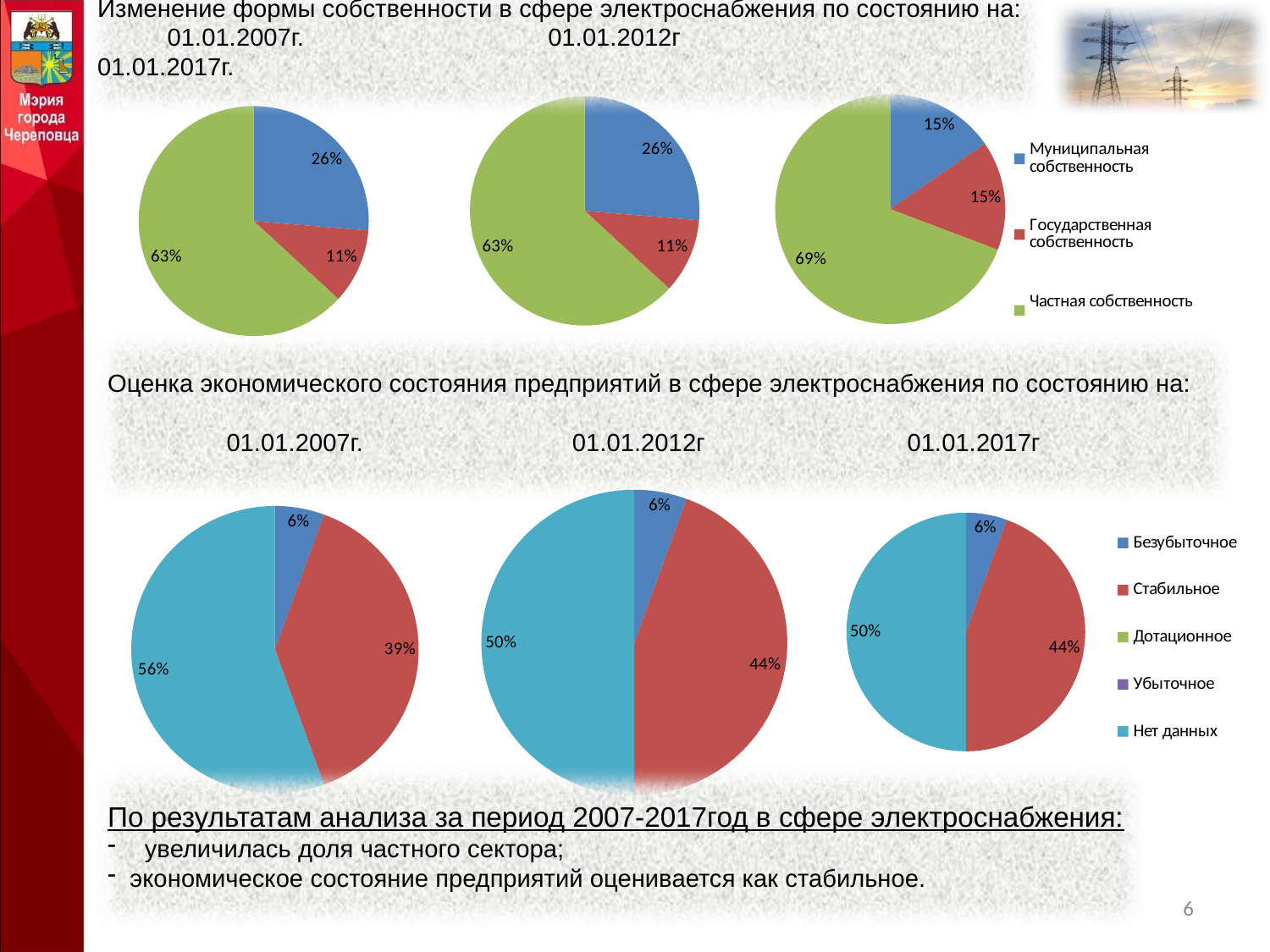
By how many percentage points did the share of Частная собственность change between the 01.01.2012 and 01.01.2017 ownership pie charts? 6 What type of chart is used for the ownership form data in the top row? Pie chart In the bottom-row economic condition pie chart for 01.01.2007, what share is Стабильное? 39% How many entries does the legend of the bottom-row economic condition pie charts list? 5 In the bottom-row economic condition pie chart for 01.01.2017, what share is Безубыточное? 6% In the bottom-row economic condition pie chart for 01.01.2007, which is larger: Стабильное or Нет данных? Нет данных In the bottom-row economic condition pie chart for 01.01.2012, what share is Нет данных? 50% In the top-row ownership pie chart for 01.01.2017, which category has the largest share? Частная собственность In the top-row ownership pie chart for 01.01.2007, which category has the smallest share? Государственная собственность In the top-row ownership pie chart for 01.01.2017, what share is Частная собственность? 69% In the top-row ownership pie chart for 01.01.2012, what share is Государственная собственность? 11% In the top-row ownership pie chart for 01.01.2007, what share is Муниципальная собственность? 26%